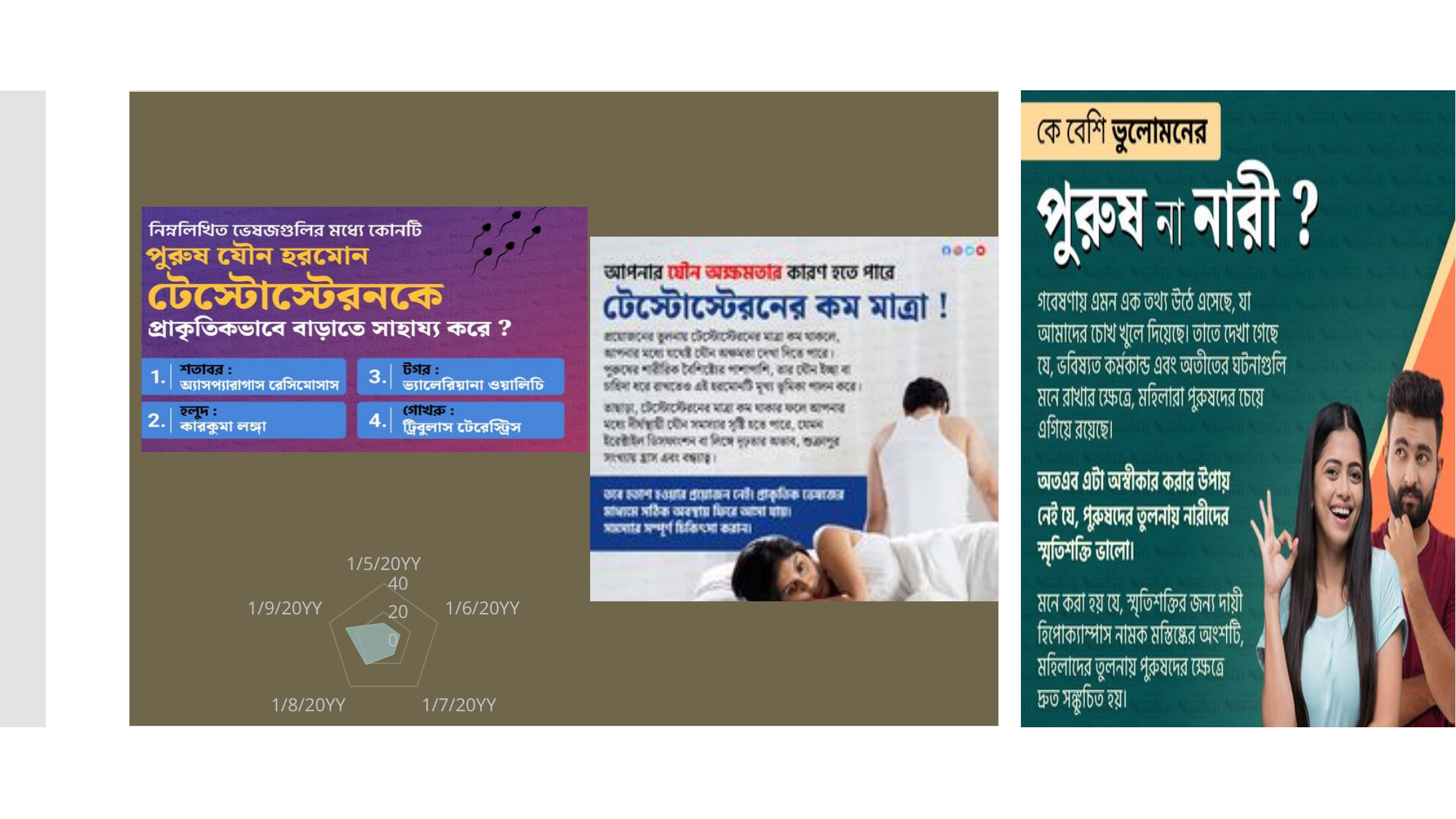
Is the value for 1/7/20YY on the radar chart greater or less than 40? less Is the value for 1/6/20YY on the radar chart greater or less than 40? less Is the value for 1/9/20YY on the radar chart greater or less than 40? less Which category label appears at the top of the radar chart? 1/5/20YY How many categories does the radar chart have? 5 What is the highest tick value shown on the radar chart's axis? 40 What kind of chart is shown at the bottom left of the slide? radar chart